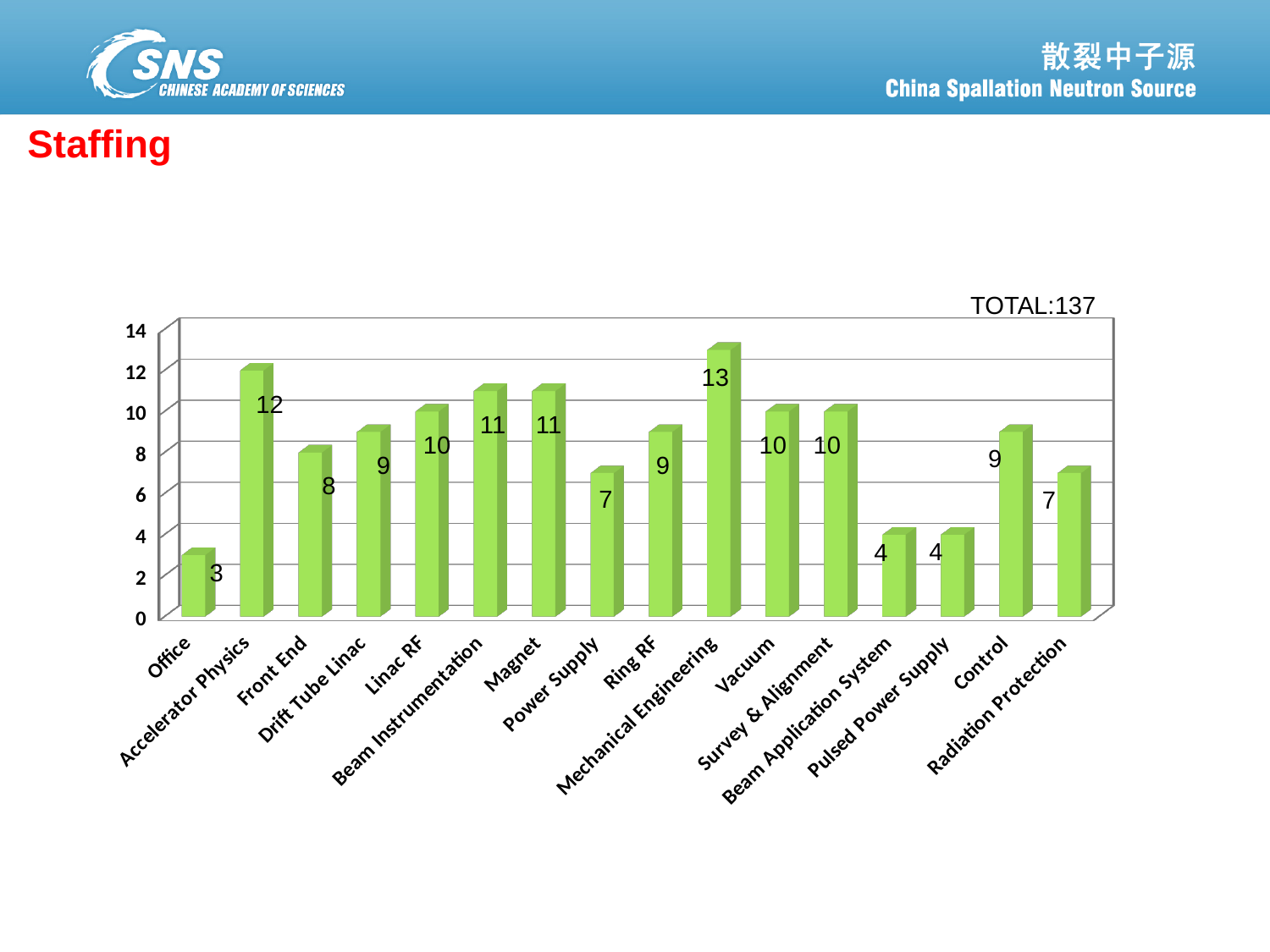
What is the title of the slide containing the chart? Staffing Which is larger, the value for Vacuum or the value for Power Supply? Vacuum Which category has the lowest value? Office What total is printed above the chart? TOTAL:137 What kind of chart is shown on the slide? Bar chart What is the value for Accelerator Physics? 12 What is the difference between the values for Accelerator Physics and Front End? 4 What is the value for Mechanical Engineering? 13 What is the value for Radiation Protection? 7 Which category has the highest value? Mechanical Engineering How many categories are shown on the x axis? 16 What is the value for Office? 3